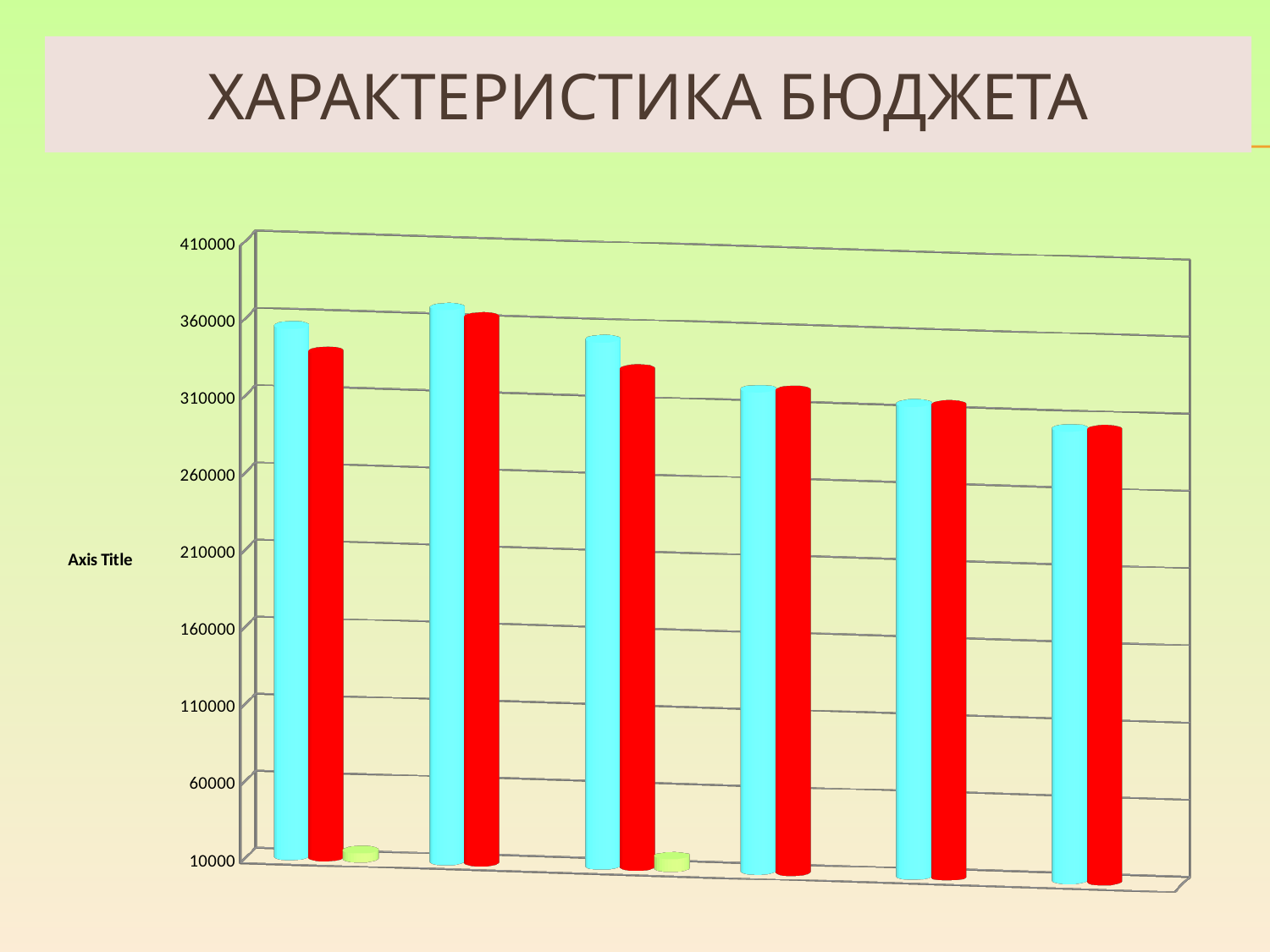
Is the value of the cyan bar in the first group from the left greater or less than 310000? greater What text is shown as the vertical axis title? Axis Title In the first group from the left, which bar is taller, the cyan one or the red one? the cyan one Is the value of the red bar in the third group from the left greater or less than 310000? greater From the second group onward, do the cyan bar values rise or fall moving left to right? fall Which group of bars has the shortest red bar? the last group on the right Is the value of the cyan bar in the last group on the right greater or less than 260000? greater How many groups of bars are plotted along the x axis? 6 What is the highest tick value shown on the vertical axis? 410000 What kind of chart is shown on the slide? bar chart Which group of bars has the tallest cyan bar? the second group from the left